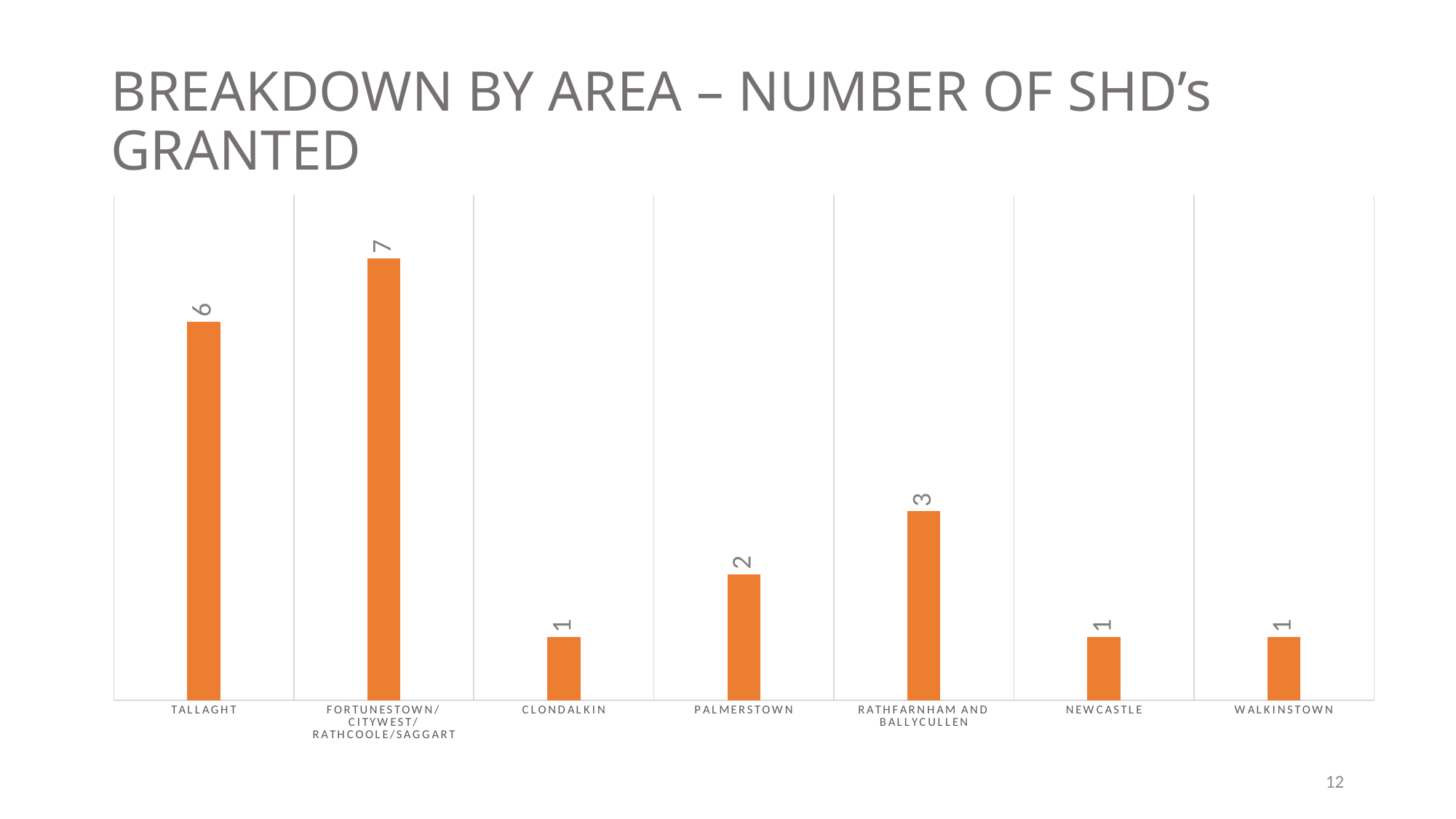
How many areas have a value of 1? 3 What is the value for Palmerstown? 2 What is the value shown for Fortunestown/Citywest/Rathcoole/Saggart? 7 What is the difference between the values for Fortunestown/Citywest/Rathcoole/Saggart and Tallaght? 1 Which is larger, the value for Rathfarnham and Ballycullen or the value for Palmerstown? Rathfarnham and Ballycullen What kind of chart is shown on the slide? Bar chart How many SHD's were granted in Rathfarnham and Ballycullen? 3 What is the difference between the values for Tallaght and Clondalkin? 5 What colour are the bars in the chart? Orange Which area has the highest number of SHD's granted? Fortunestown/Citywest/Rathcoole/Saggart How many SHD's were granted in Tallaght? 6 How many areas are shown on the chart? 7